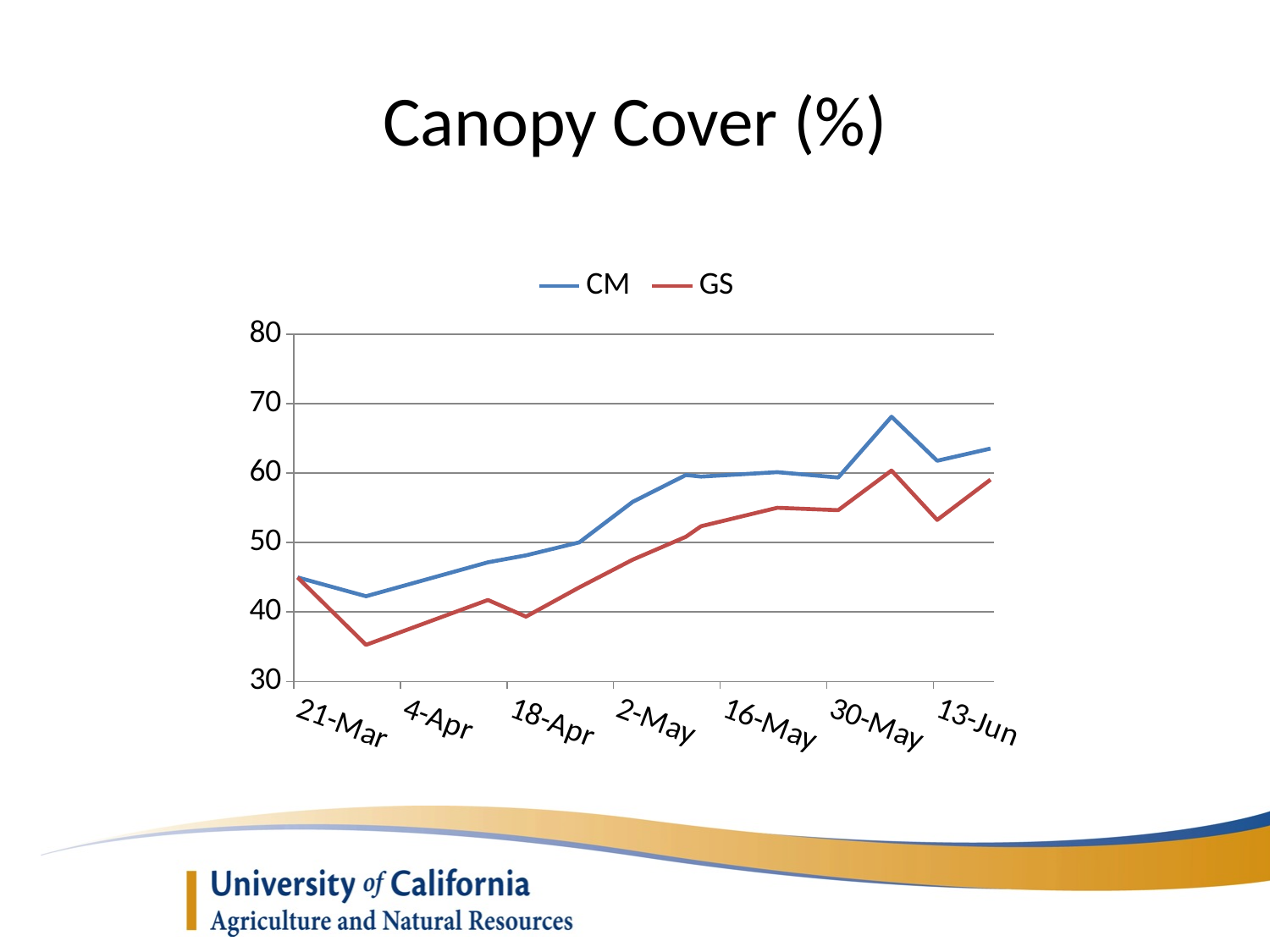
Which colour is the CM line drawn in? blue How many series does the legend list? 2 Is the value for GS at 4-Apr greater or less than 40? less At 2-May, which series has the larger value, CM or GS? CM What kind of chart is shown on the slide? line chart What is the title of the chart? Canopy Cover (%) Is the value for CM at 2-May greater or less than 50? greater Is the value for GS at 16-May greater or less than 50? greater Overall, does the GS line rise or fall from 21-Mar to 13-Jun? rise Which series reaches the highest value anywhere on the chart? CM